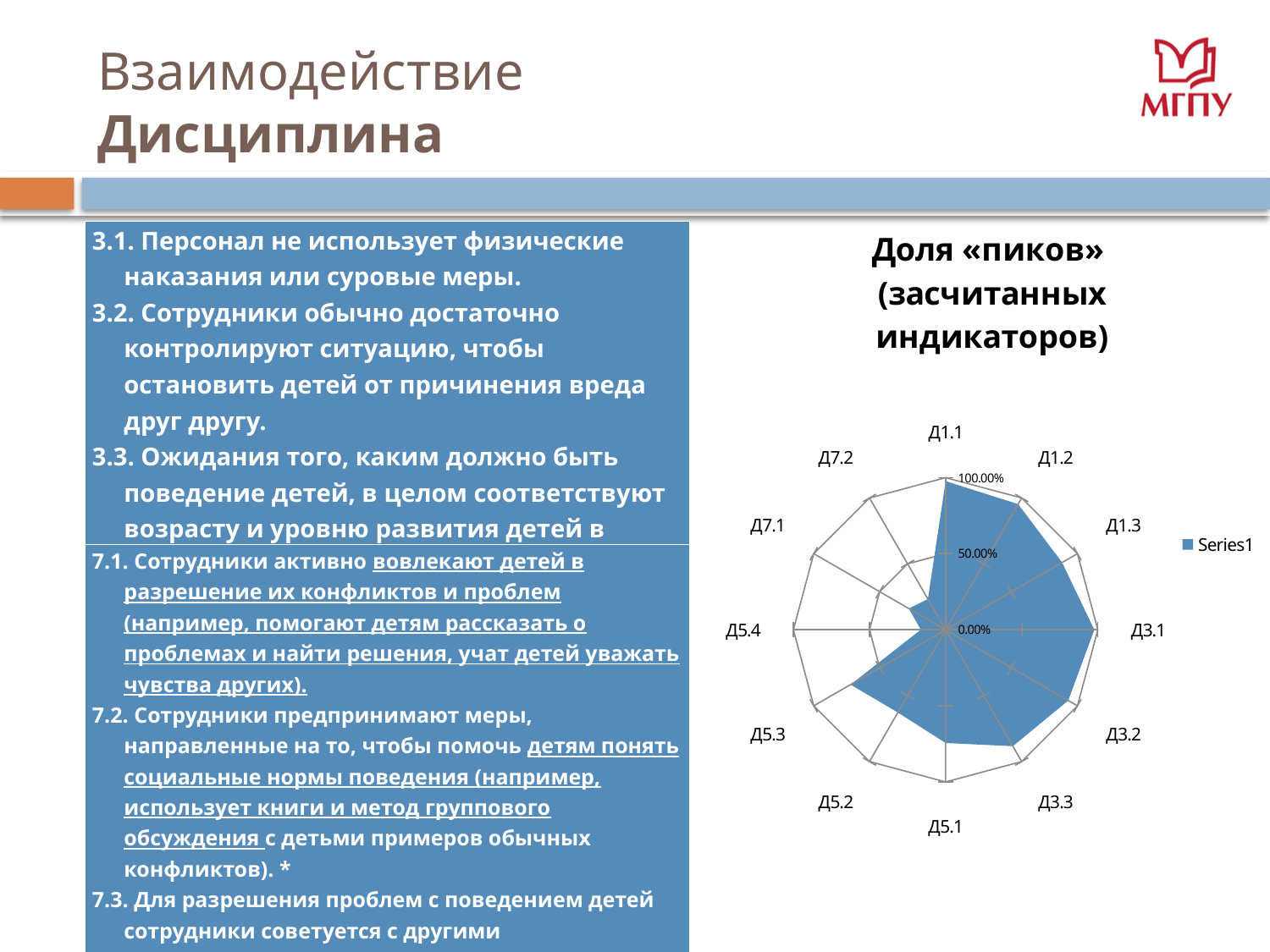
What is the title of the chart? Доля «пиков» (засчитанных индикаторов) Is the value for Д3.2 greater or less than 50.00%? greater Is the value for Д5.4 greater or less than 50.00%? less What is the name of the series shown in the legend? Series1 Is the value for Д1.1 greater or less than 50.00%? greater How many categories are plotted around the radar chart? 12 Which category has the lowest value on the chart? Д5.4 How many series does the legend list? 1 Which is larger, the value for Д3.1 or the value for Д5.4? Д3.1 What kind of chart is shown on the slide? radar chart